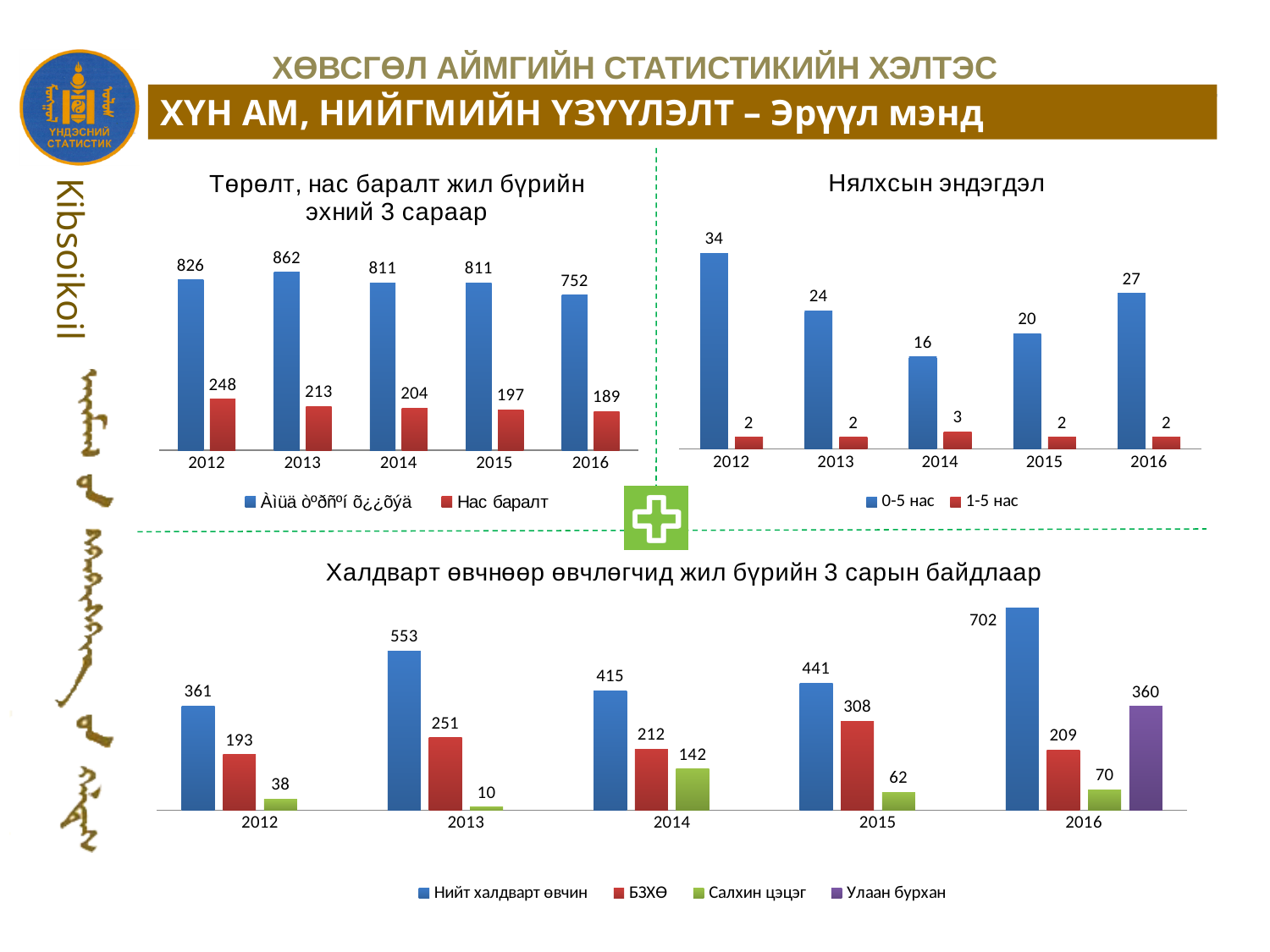
In the bottom chart titled "Халдварт өвчнөөр өвчлөгчид жил бүрийн 3 сарын байдлаар", what is the value for Нийт халдварт өвчин in 2016? 702 In the bottom chart titled "Халдварт өвчнөөр өвчлөгчид жил бүрийн 3 сарын байдлаар", which year has the lowest value for Салхин цэцэг? 2013 In the chart titled "Нялхсын эндэгдэл", which year has the lowest value for 0-5 нас? 2014 In the bottom chart titled "Халдварт өвчнөөр өвчлөгчид жил бүрийн 3 сарын байдлаар", which is larger: БЗХӨ in 2015 or БЗХӨ in 2013? БЗХӨ in 2015 In the top-left chart titled "Төрөлт, нас баралт жил бүрийн эхний 3 сараар", which year has the highest value for the blue series? 2013 In the top-left chart titled "Төрөлт, нас баралт жил бүрийн эхний 3 сараар", do the Нас баралт values rise or fall from 2012 to 2016? fall In the chart titled "Нялхсын эндэгдэл", how many series does the legend list? 2 In the top-left chart titled "Төрөлт, нас баралт жил бүрийн эхний 3 сараар", what is the value for Нас баралт in 2014? 204 In the chart titled "Нялхсын эндэгдэл", what is the value for 0-5 нас in 2012? 34 In the chart titled "Нялхсын эндэгдэл", what is the difference between the 0-5 нас values for 2012 and 2016? 7 In the top-left chart titled "Төрөлт, нас баралт жил бүрийн эхний 3 сараар", how many years are shown on the x axis? 5 What kind of chart is the bottom chart titled "Халдварт өвчнөөр өвчлөгчид жил бүрийн 3 сарын байдлаар"? bar chart